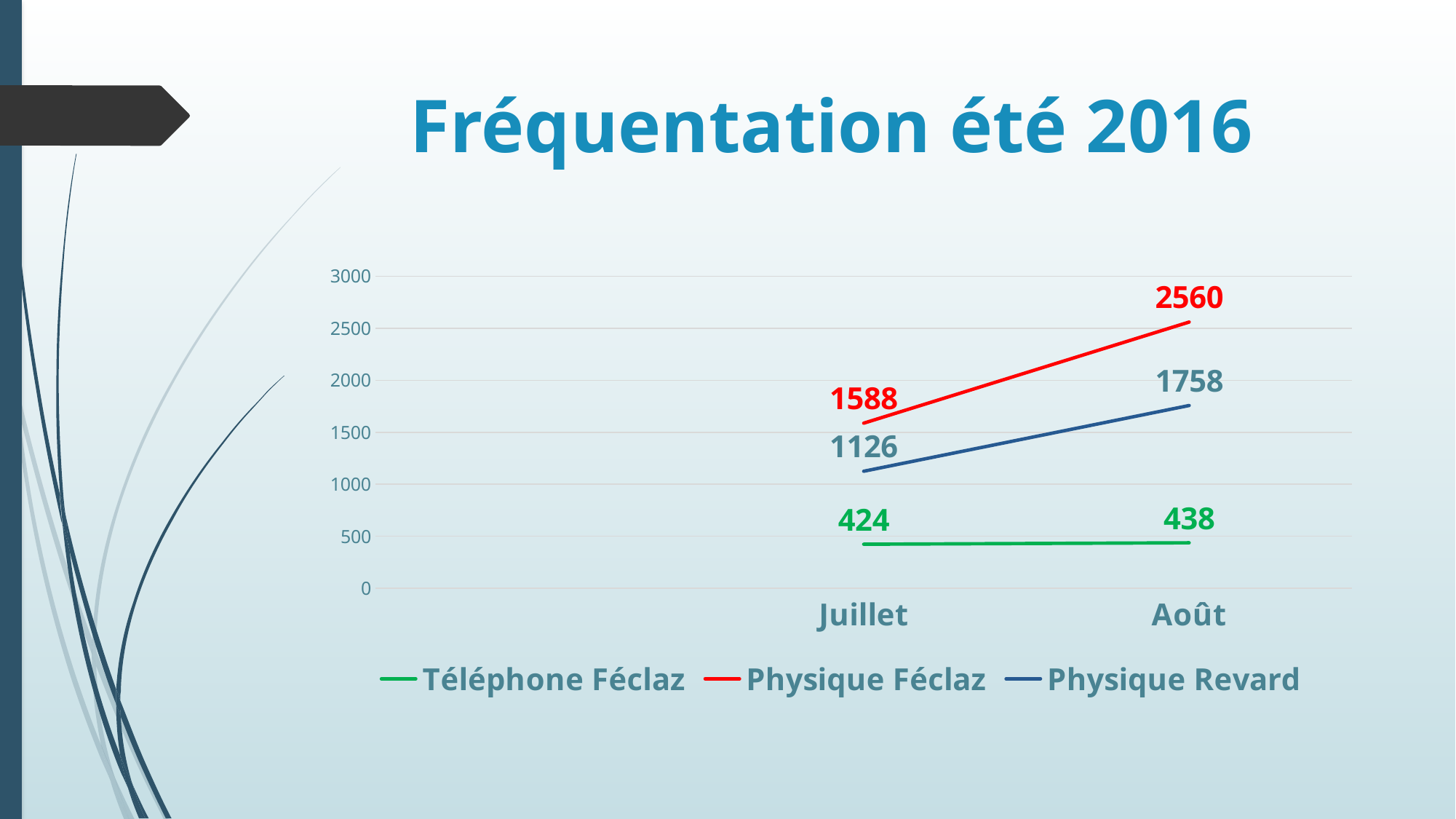
What is the difference between the Physique Féclaz values for Août and Juillet? 972 What is the difference between Physique Féclaz and Physique Revard in Août? 802 What kind of chart is shown on the slide? line chart What is the value for Téléphone Féclaz in Août? 438 Does the Physique Revard series rise or fall from Juillet to Août? rise Is the value for Physique Revard in Août greater or less than 2000? less Which is larger: Physique Revard in Août or Physique Féclaz in Juillet? Physique Revard in Août How many series does the legend list? 3 What is the value for Physique Revard in Juillet? 1126 Which series has the highest value in Août? Physique Féclaz What is the value for Physique Féclaz in Août? 2560 Which series has the lowest value in Juillet? Téléphone Féclaz